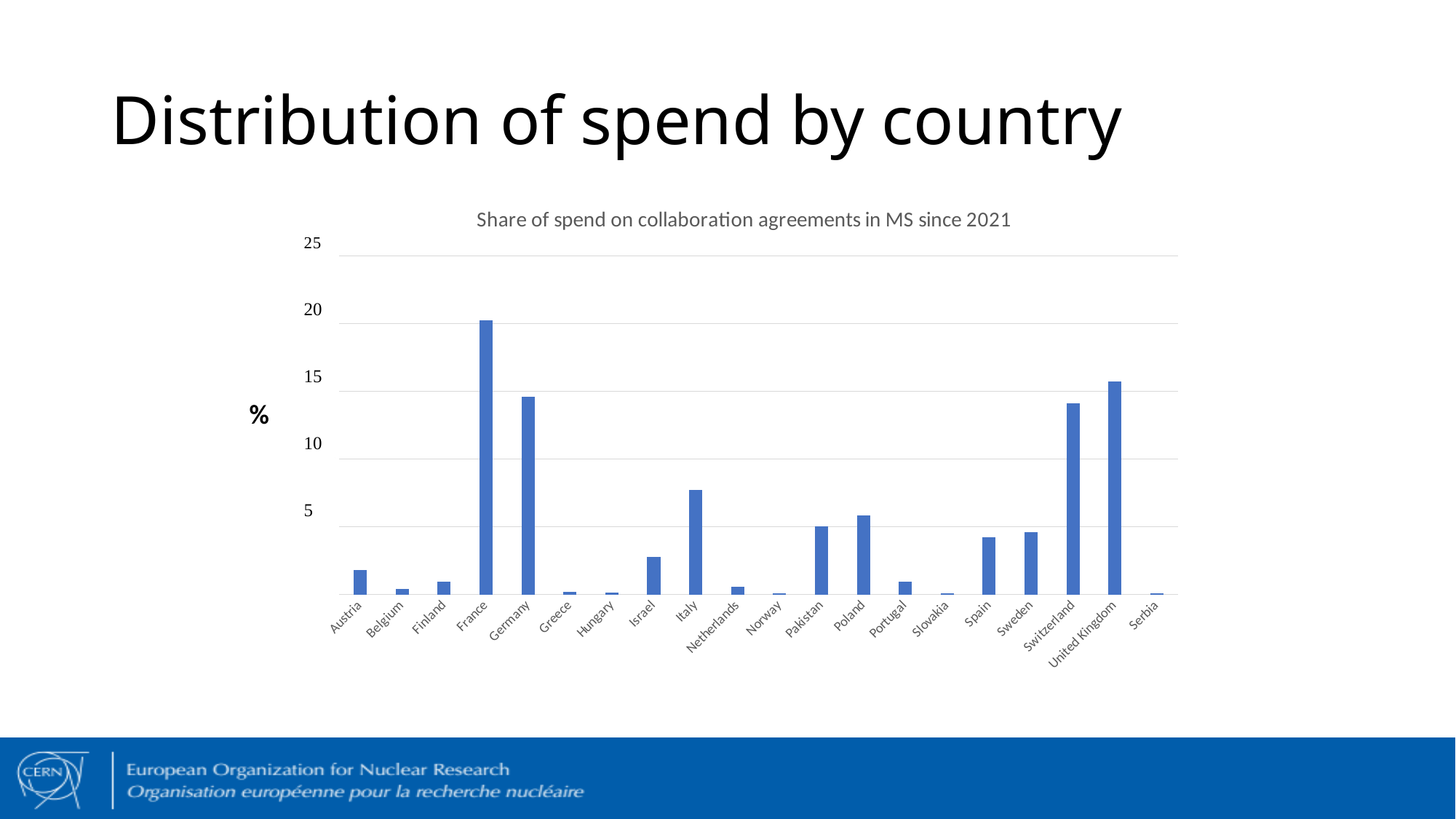
Which has a larger share of spend, Italy or Poland? Italy What is the title of the chart? Share of spend on collaboration agreements in MS since 2021 Is the value for France greater or less than 15? greater Which country has the highest share of spend? France Is the value for Switzerland greater or less than 15? less How many countries are shown on the x axis of the chart? 20 What kind of chart is shown on the slide? bar chart Is the value for Spain greater or less than 5? less Which has a larger share of spend, France or Germany? France What label is shown on the vertical axis of the chart? %